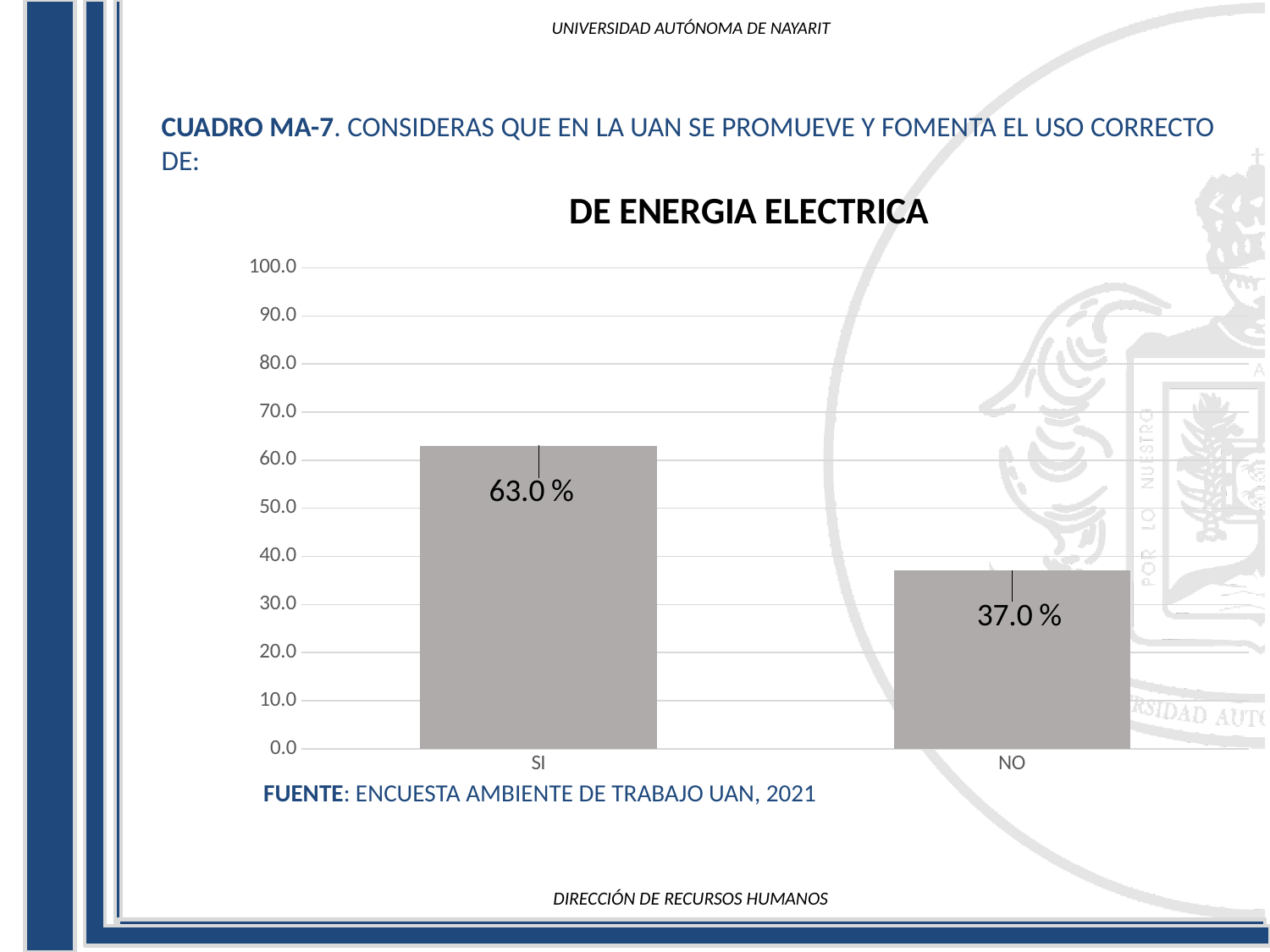
How many categories are shown on the x axis? 2 What is the highest value shown on the y axis? 100.0 What is the difference between the values for SI and NO? 26.0 % What is the value for SI? 63.0 % What is the value for NO? 37.0 % Which category has the highest value? SI What kind of chart is shown? bar chart What is the title of the chart? DE ENERGIA ELECTRICA Which is larger, the value for SI or the value for NO? SI Which category has the lowest value? NO Is the value for NO greater or less than 40.0? less Is the value for SI greater or less than 60.0? greater